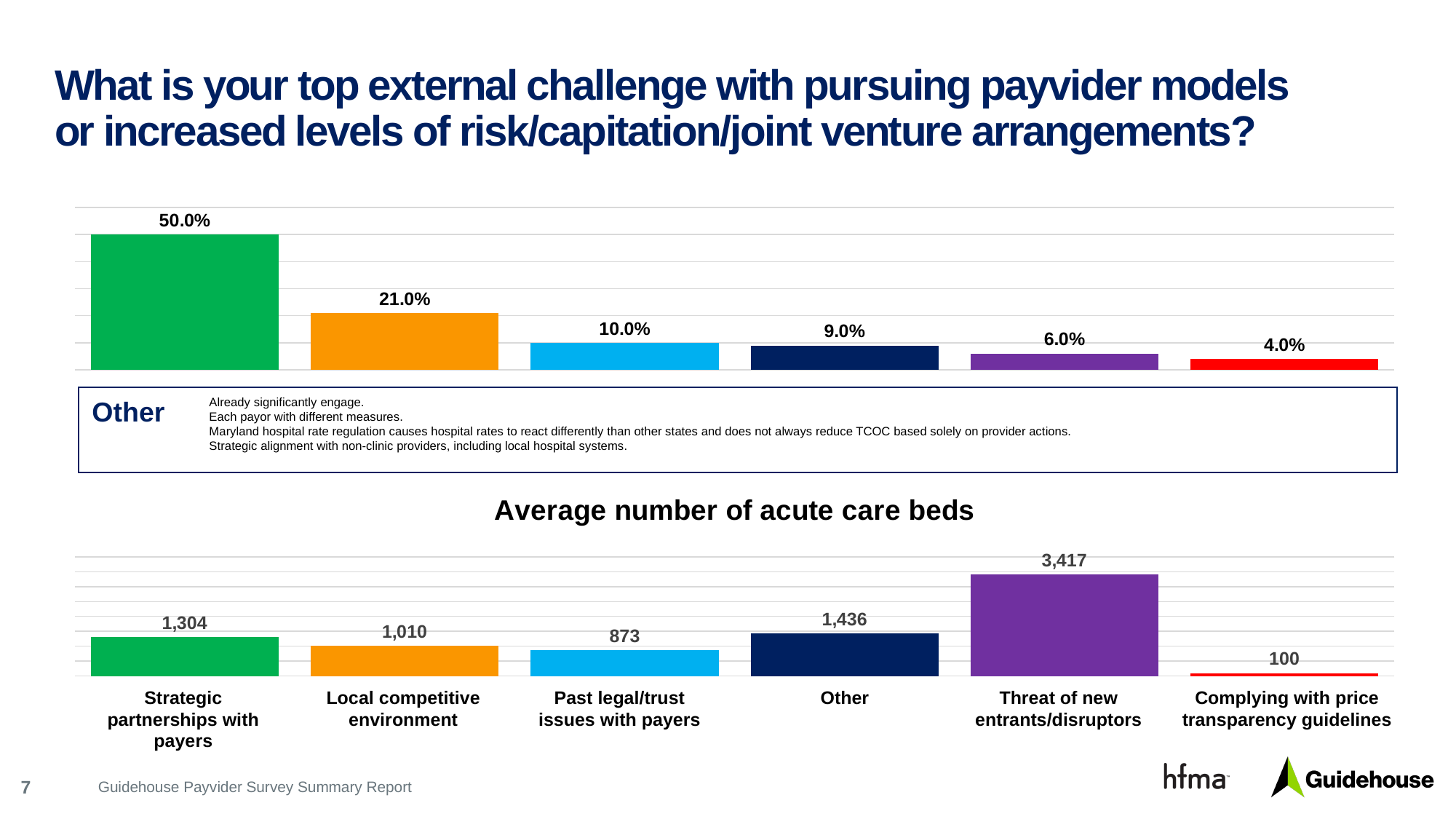
In the top chart, what percentage is shown for Threat of new entrants/disruptors? 6.0% In the top chart, what percentage is shown for Strategic partnerships with payers? 50.0% In the Average number of acute care beds chart, which category has the highest value? Threat of new entrants/disruptors In the top chart, which is larger: the value for Past legal/trust issues with payers or the value for Other? Past legal/trust issues with payers In the Average number of acute care beds chart, what is the difference between the values for Other and Local competitive environment? 426 What kind of chart is the Average number of acute care beds chart? Bar chart How many categories are shown in the top chart? 6 In the Average number of acute care beds chart, what colour is the bar for Complying with price transparency guidelines? Red In the Average number of acute care beds chart, what is the value for Threat of new entrants/disruptors? 3,417 In the Average number of acute care beds chart, what is the value for Past legal/trust issues with payers? 873 In the top chart, which category has the lowest percentage? Complying with price transparency guidelines In the top chart, what is the difference between the percentages for Strategic partnerships with payers and Local competitive environment? 29.0%